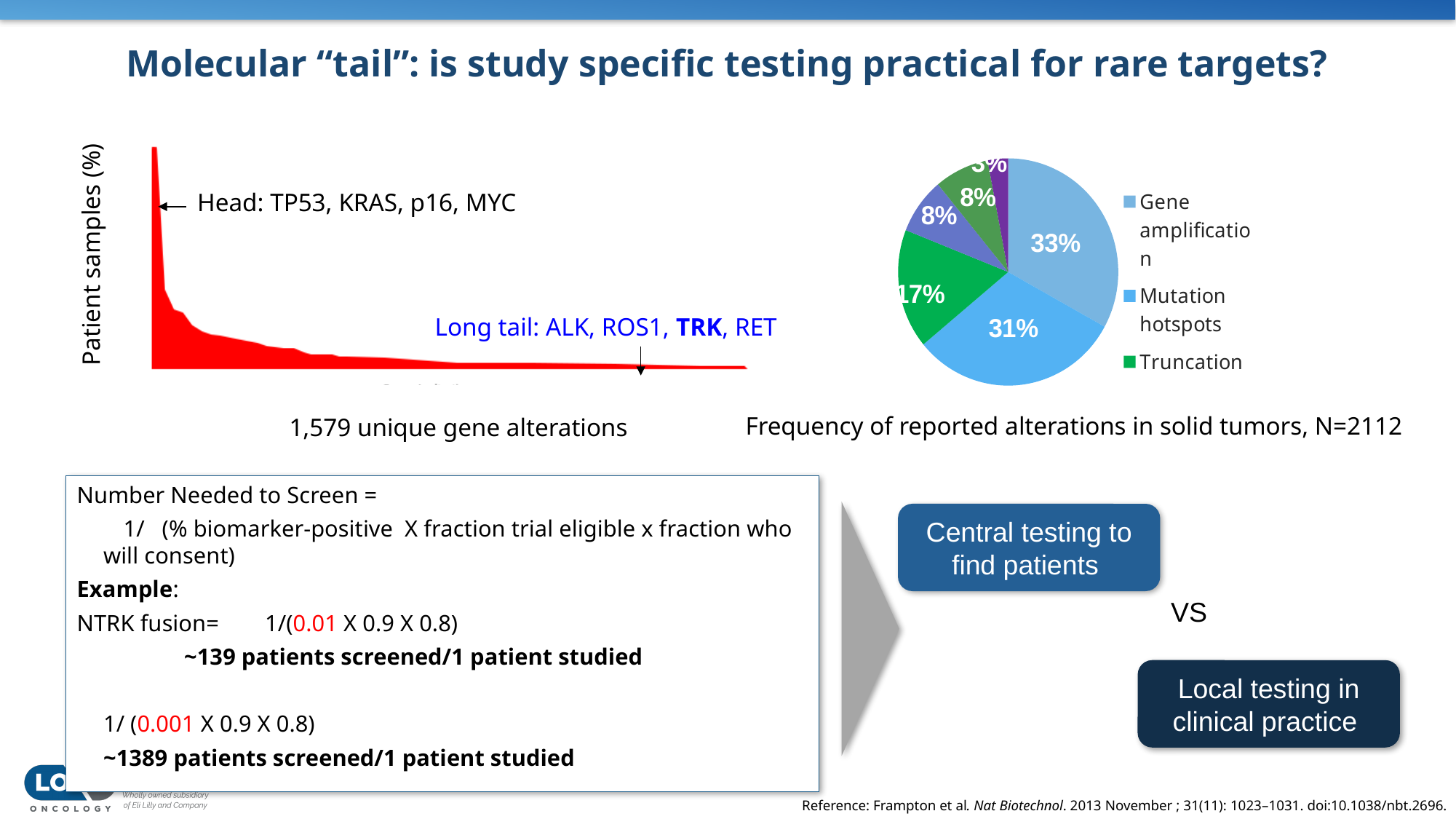
In the pie chart, what is the difference between the Gene amplification and Mutation hotspots slices? 2% In the pie chart, which is larger: Mutation hotspots or Truncation? Mutation hotspots According to the caption under the pie chart, what is the sample size N? N=2112 In the red chart on the left, do the values rise or fall along the x axis? Fall How many slices does the pie chart have? 6 What kind of chart is the chart on the right of the slide? Pie chart In the pie chart, which category has the largest slice? Gene amplification In the pie chart, what percentage is shown for Mutation hotspots? 31% What is the y-axis label of the red chart on the left? Patient samples (%) In the pie chart, what percentage is shown for Gene amplification? 33% In the pie chart, what percentage is shown for Truncation? 17% In the pie chart, what is the difference between the Gene amplification and Truncation slices? 16%